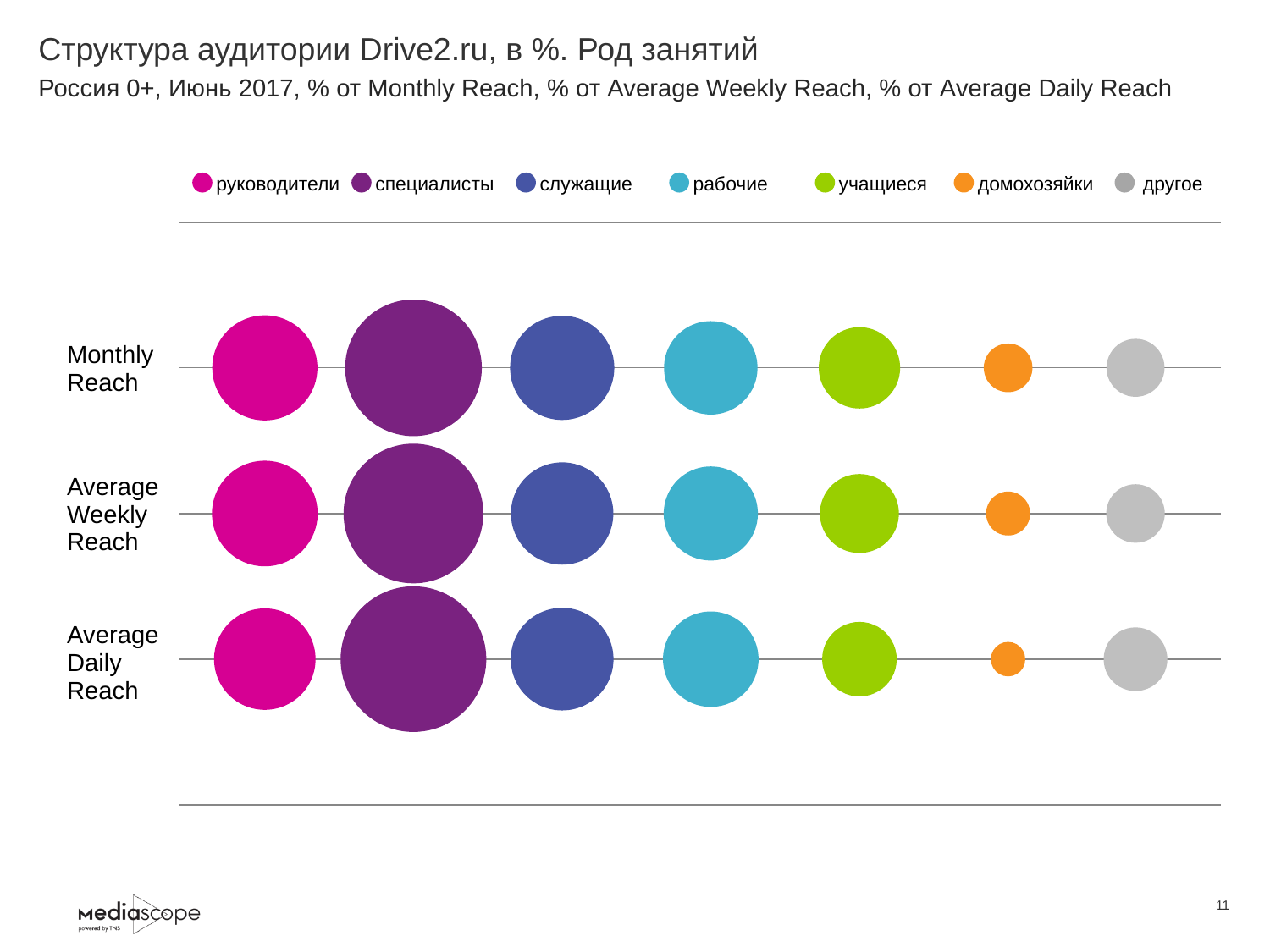
How many series does the legend list? 7 What is the title of the chart on the slide? Структура аудитории Drive2.ru, в %. Род занятий What kind of chart is shown on the slide? bubble chart Which legend entry is shown in orange? домохозяйки In the Average Weekly Reach row, which bubble is larger: руководители or домохозяйки? руководители In the Monthly Reach row, which bubble is larger: специалисты or учащиеся? специалисты Which occupation group has the smallest bubble in the Average Daily Reach row? домохозяйки Which occupation group has the largest bubble in the Average Daily Reach row? специалисты Which occupation group has the smallest bubble in the Monthly Reach row? домохозяйки How many reach categories (rows) are plotted on the chart? 3 Which occupation group has the largest bubble in the Monthly Reach row? специалисты